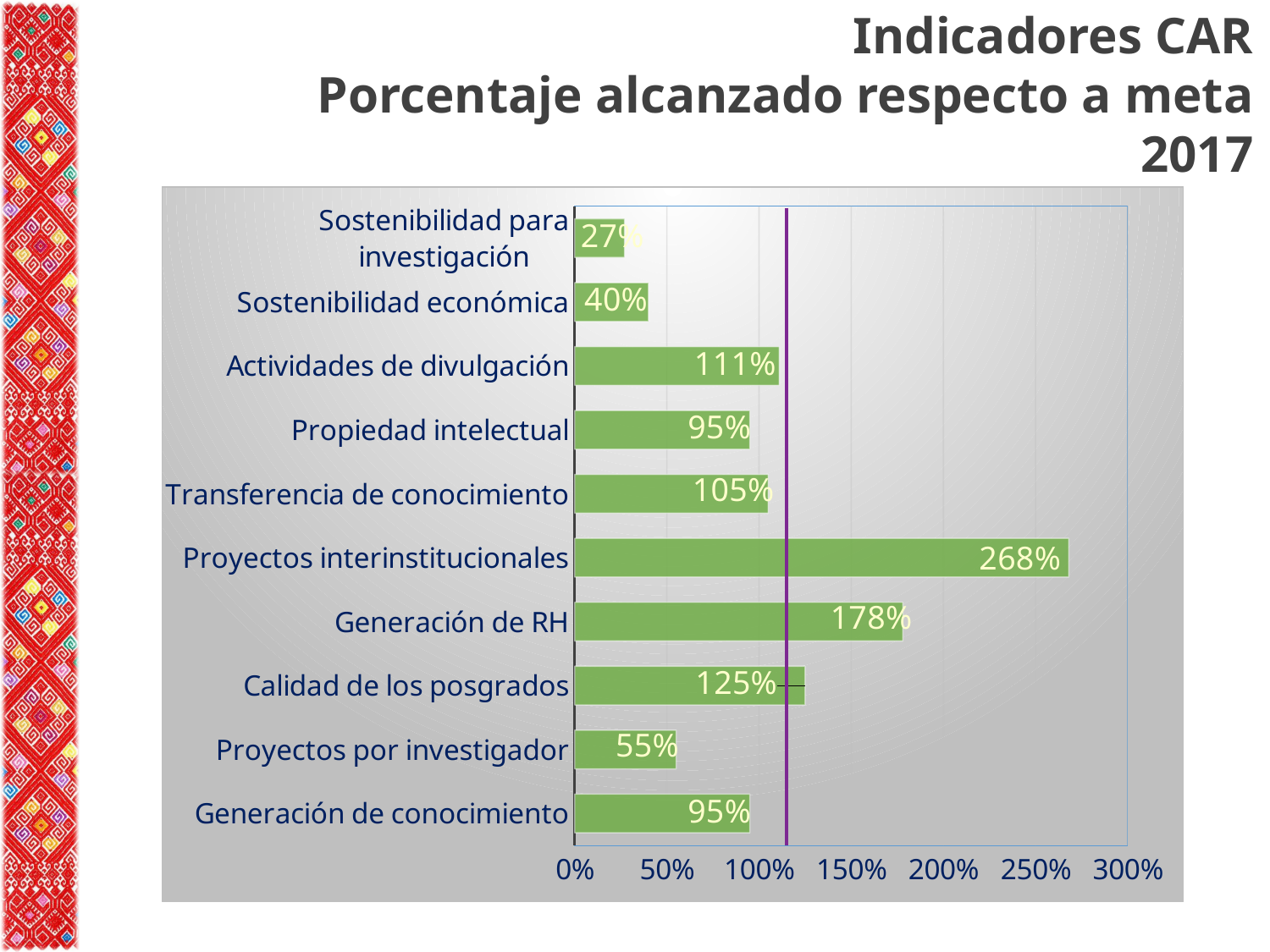
What is the value for Proyectos interinstitucionales? 268% Is the value for Calidad de los posgrados greater or less than 100%? greater Which category has the lowest value? Sostenibilidad para investigación What is the title of the chart on the slide? Indicadores CAR Porcentaje alcanzado respecto a meta 2017 How many categories are shown in the chart? 10 What is the value for Generación de RH? 178% Which is larger, Actividades de divulgación or Transferencia de conocimiento? Actividades de divulgación Which category has the highest value? Proyectos interinstitucionales What is the difference between Proyectos por investigador and Sostenibilidad para investigación? 28% What is the value for Sostenibilidad económica? 40% What is the difference between Proyectos interinstitucionales and Generación de RH? 90% What kind of chart is shown on the slide? Bar chart